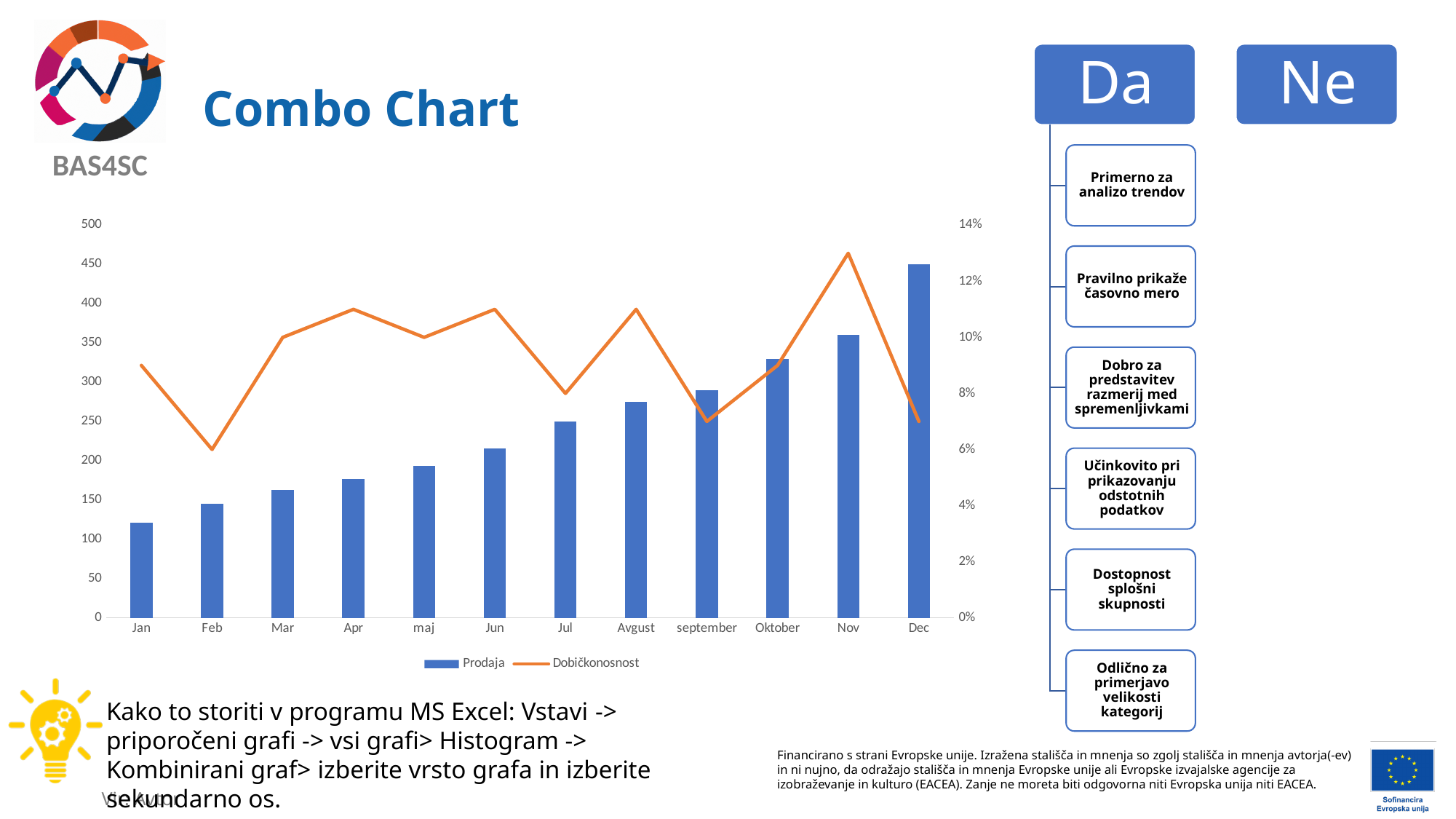
In which month does the Dobičkonosnost line reach its lowest point? Feb Which month has the larger Prodaja bar, Jul or Oktober? Oktober Is the Prodaja value for Dec greater or less than 400? greater How many months are shown on the x axis of the chart? 12 Is the Prodaja value for Jan greater or less than 150? less In which month does the Dobičkonosnost line reach its highest point? Nov What kind of chart is shown on the slide? A combo chart with bars and a line Which month has the lowest Prodaja bar? Jan Is the Dobičkonosnost value for Nov greater or less than 12%? greater How many series does the chart legend list? 2 Do the Prodaja bars rise or fall from Jan to Dec? rise Which month has the highest Prodaja bar? Dec